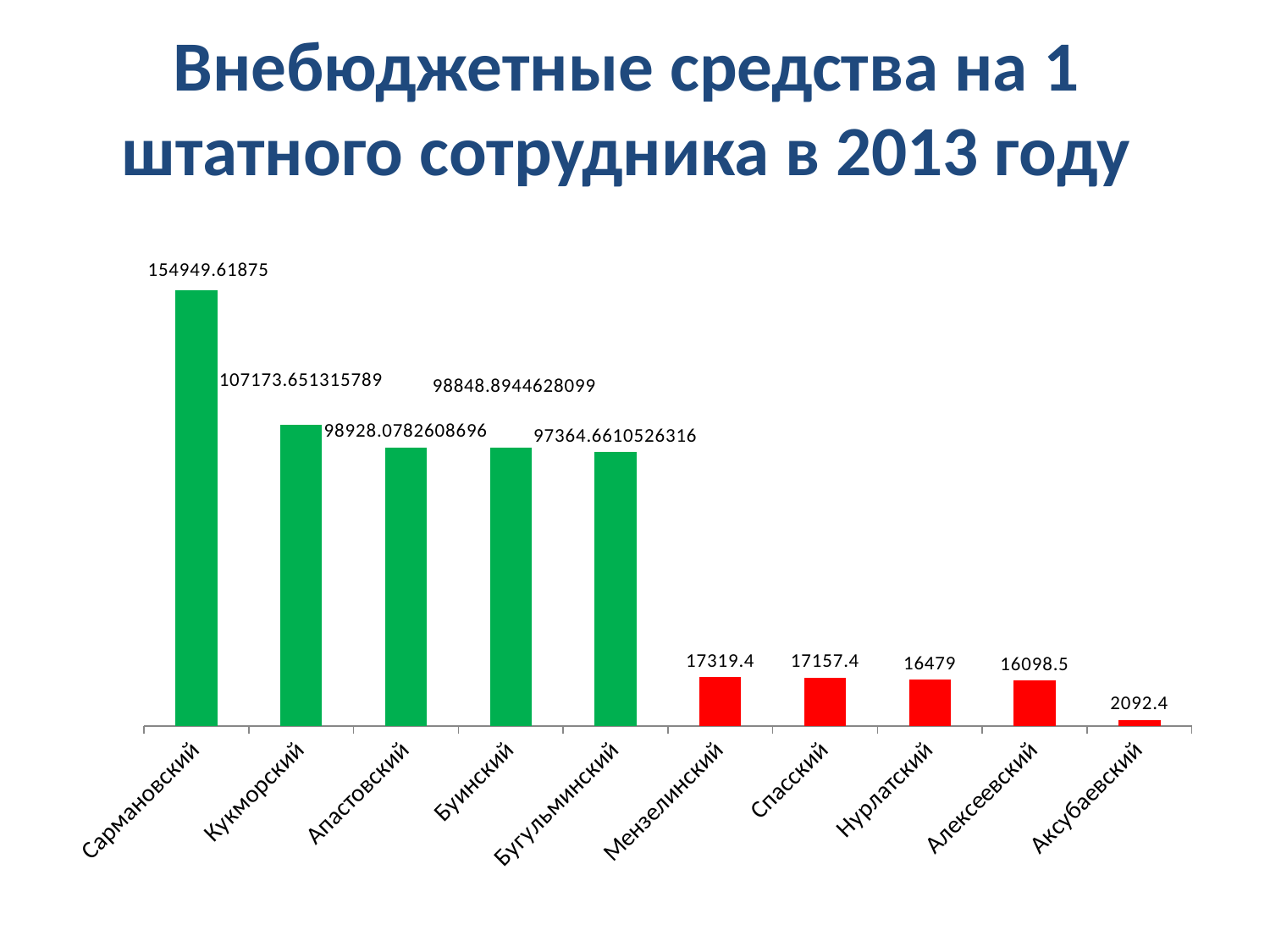
What is the value for Мензелинский? 17319.4 Which district has the highest value? Сармановский What is the value for Сармановский? 154949.61875 What is the value for Аксубаевский? 2092.4 What type of chart is shown on the slide? bar chart Which is larger, the value for Кукморский or the value for Бугульминский? Кукморский Which district has the lowest value? Аксубаевский What is the difference between the values for Мензелинский and Спасский? 162 How many categories (districts) are shown in the chart? 10 What colour are the bars for the five districts with the highest values? green What is the value for Кукморский? 107173.651315789 What is the value for Нурлатский? 16479